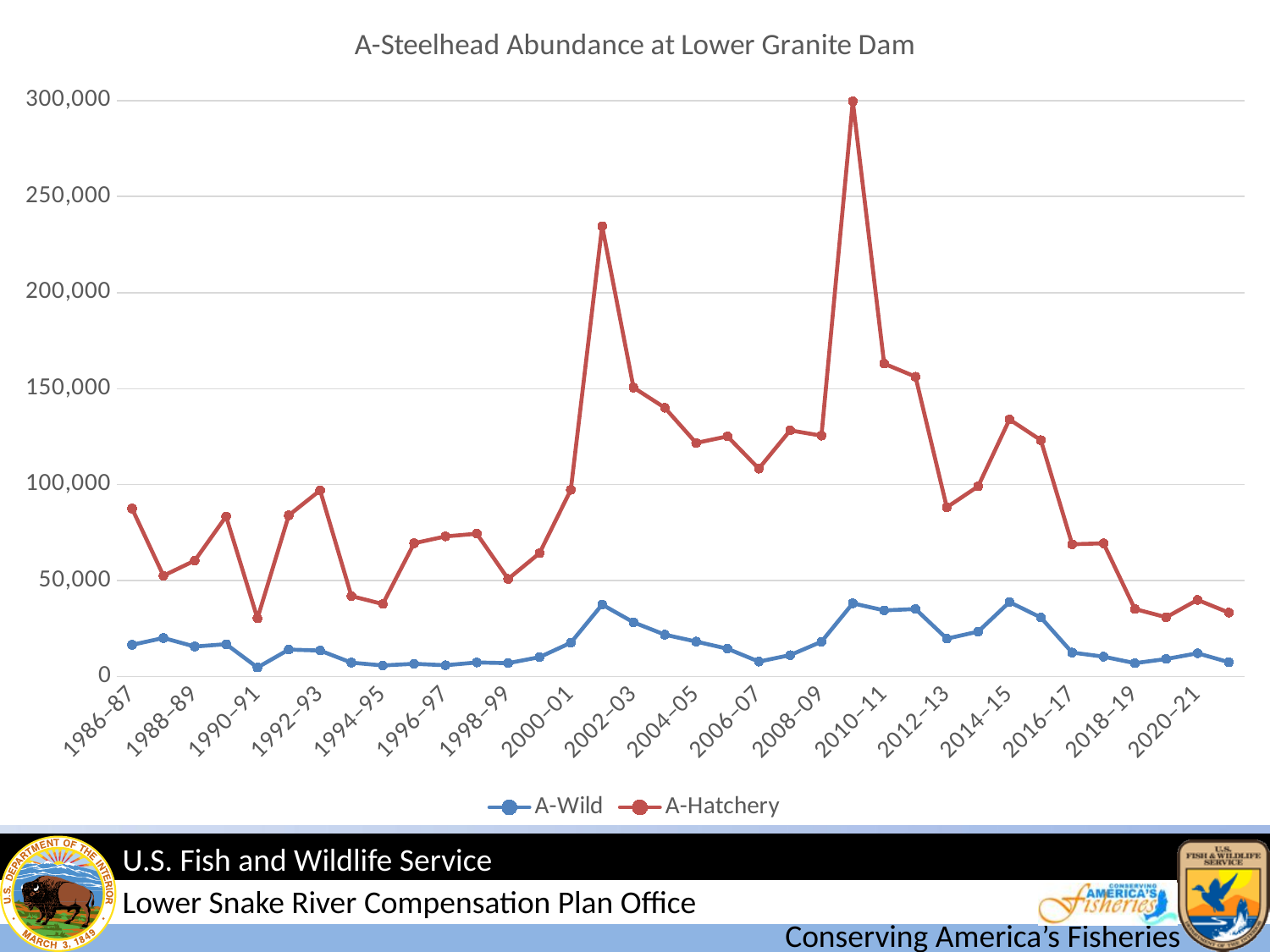
Is the A-Hatchery value for 2010–11 greater or less than 250,000? less Is the A-Hatchery value for 2002–03 greater or less than 200,000? less Which series has the larger value in 2010–11, A-Wild or A-Hatchery? A-Hatchery Which series is drawn in red? A-Hatchery How many series does the legend list? 2 What kind of chart is shown on the slide? line chart What is the title of the chart? A-Steelhead Abundance at Lower Granite Dam Is the A-Wild value for 2010–11 greater or less than 50,000? less Does the A-Hatchery series rise or fall from 2014–15 to 2018–19? fall For the A-Hatchery series, which is larger: the value in 2002–03 or the value in 2010–11? 2010–11